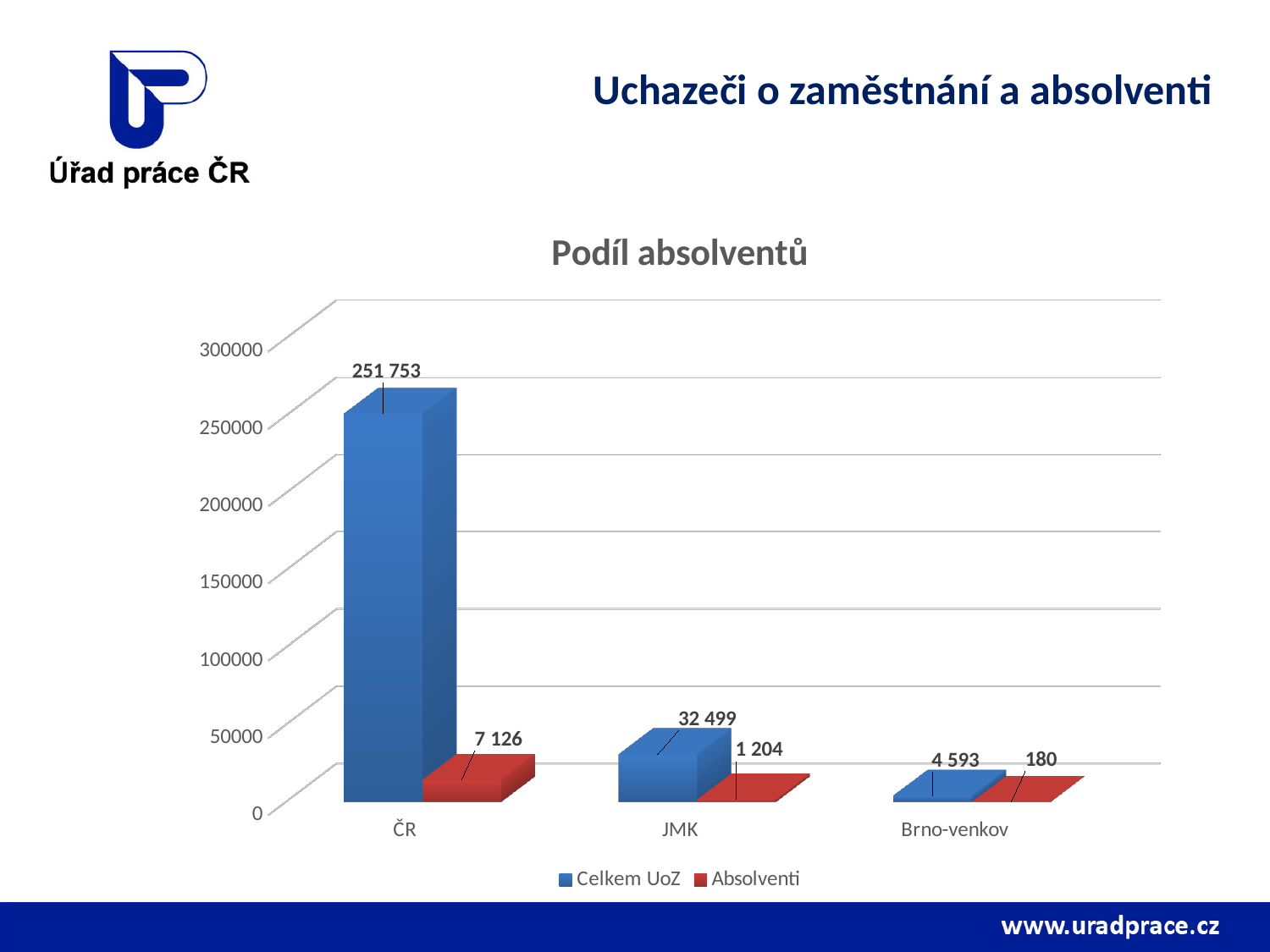
Which is larger: Absolventi for ČR or Celkem UoZ for Brno-venkov? Absolventi for ČR How many categories are shown on the x axis? 3 What is the value of Celkem UoZ for Brno-venkov? 4 593 What is the value of Absolventi for JMK? 1 204 Which category has the lowest Absolventi value? Brno-venkov What is the value of Celkem UoZ for ČR? 251 753 How many series does the legend list? 2 What is the value of Absolventi for ČR? 7 126 What is the title of the chart? Podíl absolventů Is the Celkem UoZ value for ČR greater or less than 200000? greater What is the difference between Celkem UoZ and Absolventi for JMK? 31 295 Which category has the highest Celkem UoZ value? ČR